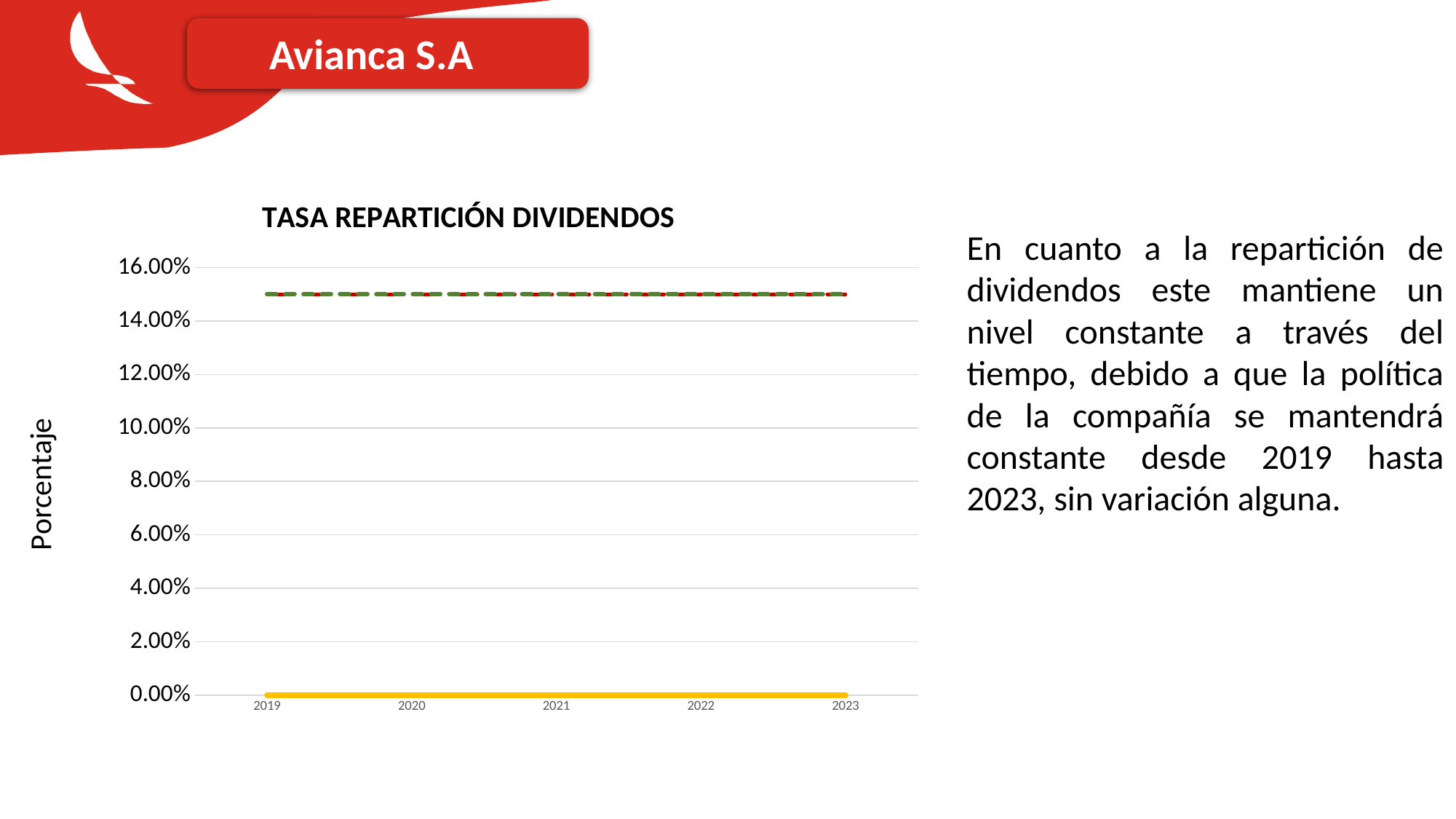
Is the value of the dashed line in 2021 greater or less than 10.00%? greater What kind of chart is shown on the slide? line chart Does the dashed line rise, fall, or stay flat from 2019 to 2023? stays flat What is the last year shown on the x axis? 2023 What is the label on the vertical axis of the chart? Porcentaje Is the value of the dashed line in 2023 greater or less than 16.00%? less How many years are shown on the x axis of the chart? 5 What value does the solid yellow line sit at across all years? 0.00% What is the highest value shown on the vertical axis? 16.00% Is the value of the dashed line in 2019 greater or less than 14.00%? greater What is the title of the chart? TASA REPARTICIÓN DIVIDENDOS What is the first year shown on the x axis? 2019